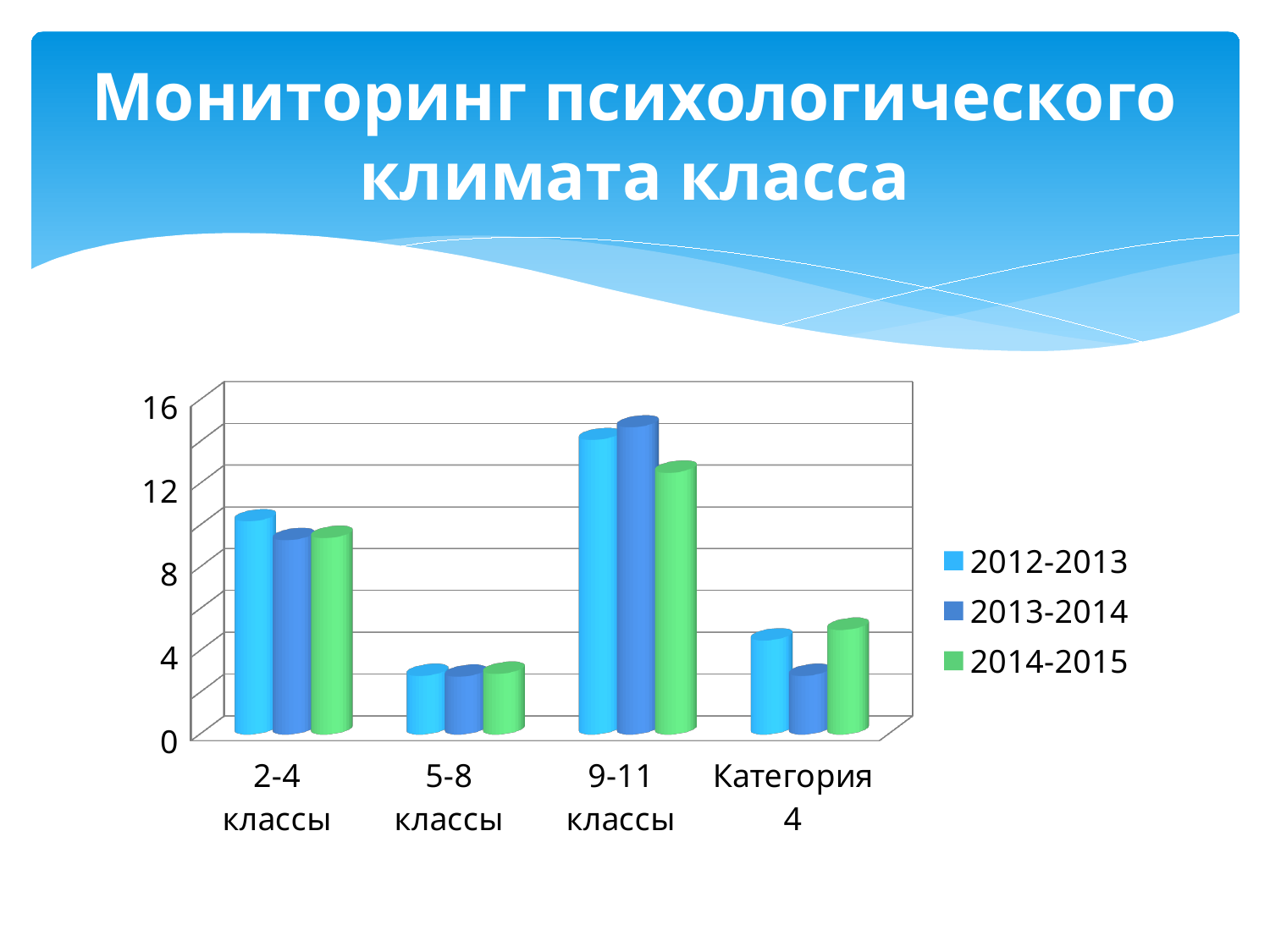
In the Категория 4 category, which series has the larger value: 2013-2014 or 2014-2015? 2014-2015 What kind of chart is shown on the slide? Bar chart Which category has the highest bars in the chart? 9-11 классы In the 9-11 классы category, which series has the larger value: 2013-2014 or 2014-2015? 2013-2014 Which category has the lowest bars in the chart? 5-8 классы Is the value for 2013-2014 in the Категория 4 category greater or less than 4? less What is the title of the slide containing the chart? Мониторинг психологического климата класса Is the value for 2012-2013 in the 9-11 классы category greater or less than 12? greater Is the value for 2012-2013 in the 2-4 классы category greater or less than 8? greater How many series does the chart's legend list? 3 How many categories are shown on the x axis of the chart? 4